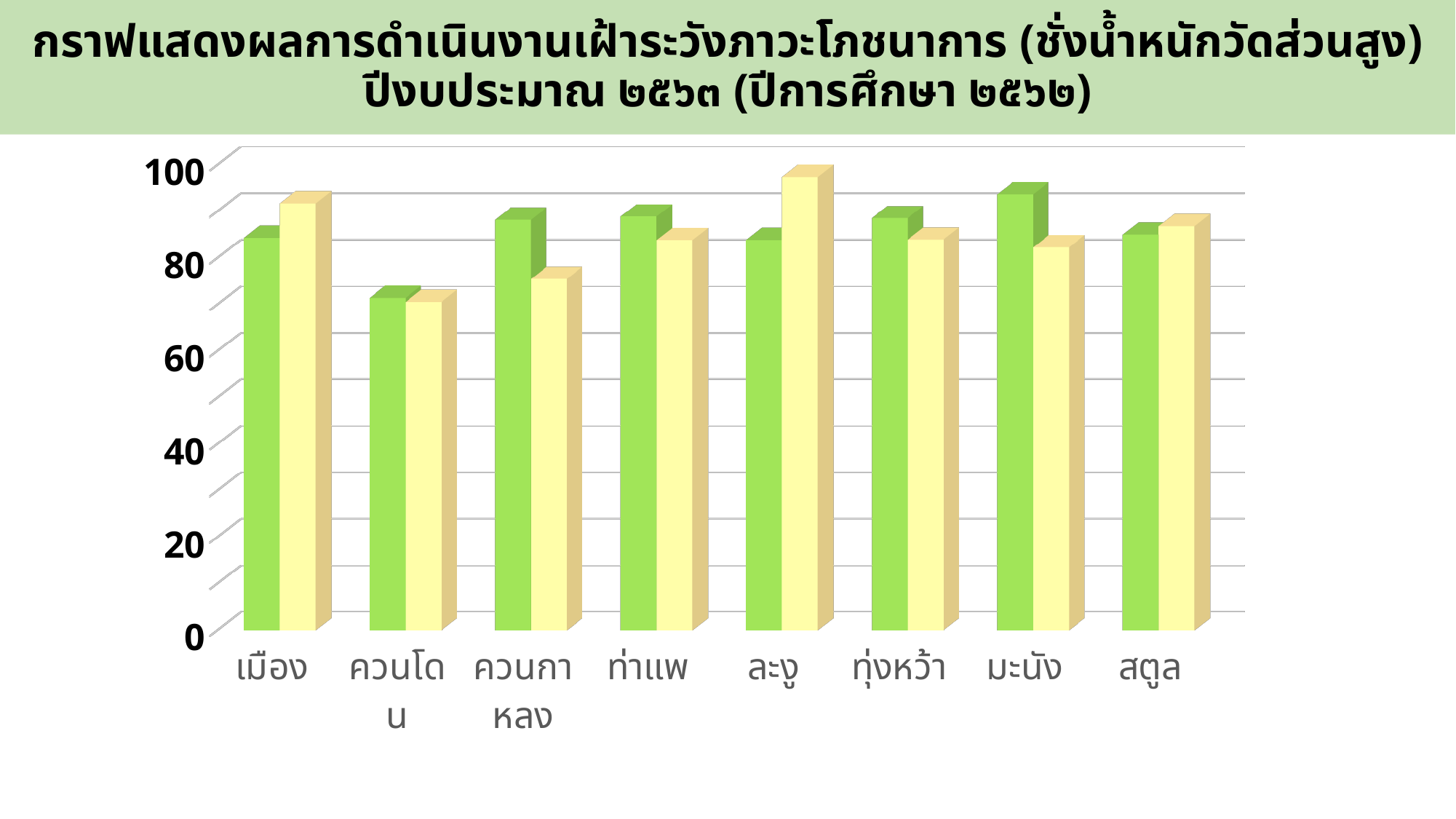
Which category has the lowest green bar in the chart? ควนโดน What kind of chart is shown on the slide? Bar chart Is the green bar for ควนโดน greater or less than 80? less What is the highest value shown on the vertical axis of the chart? 100 Which category has the highest green bar in the chart? มะนัง For ละงู, which bar is taller, the green one or the yellow one? yellow Which category has the highest yellow bar in the chart? ละงู How many categories (districts) are shown on the x axis of the chart? 8 For ควนกาหลง, which bar is taller, the green one or the yellow one? green Is the yellow bar for ละงู greater or less than 80? greater How many data series (bar colours) are plotted for each category in the chart? 2 Is the green bar for เมือง greater or less than 60? greater